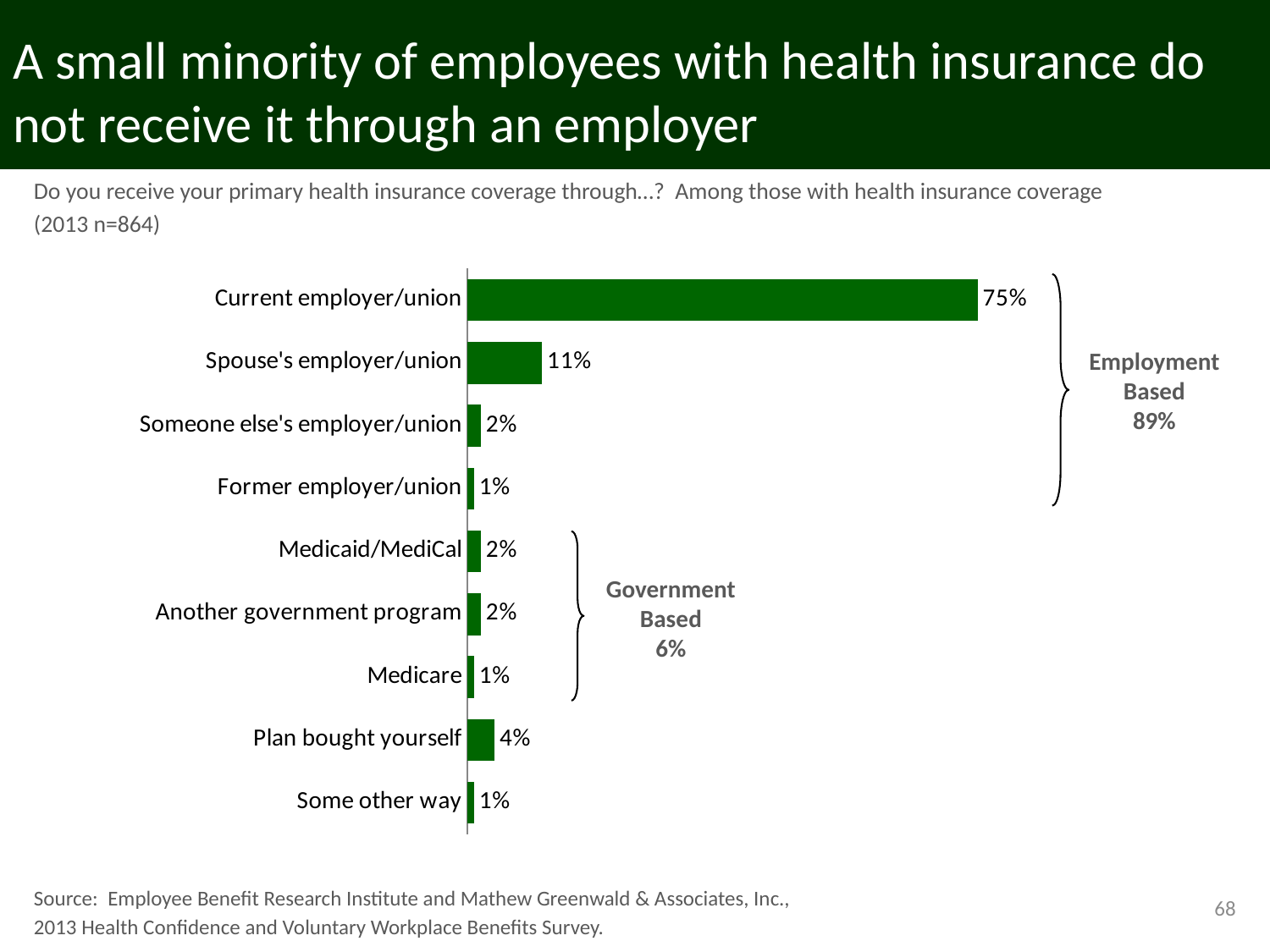
What is the combined percentage labelled as Government Based? 6% Which is larger, the value for Plan bought yourself or the value for Medicaid/MediCal? Plan bought yourself What is the combined percentage labelled as Employment Based? 89% What percentage receive coverage through a plan bought yourself? 4% How many categories are shown in the chart? 9 What is the difference between the values for Current employer/union and Spouse's employer/union? 64% What percentage receive coverage through Medicare? 1% Which category has the highest value? Current employer/union What is the sample size (n) shown for the 2013 survey? 864 What percentage receive coverage through a spouse's employer/union? 11% What kind of chart is shown on the slide? Bar chart What percentage of respondents receive their primary health insurance coverage through a current employer/union? 75%